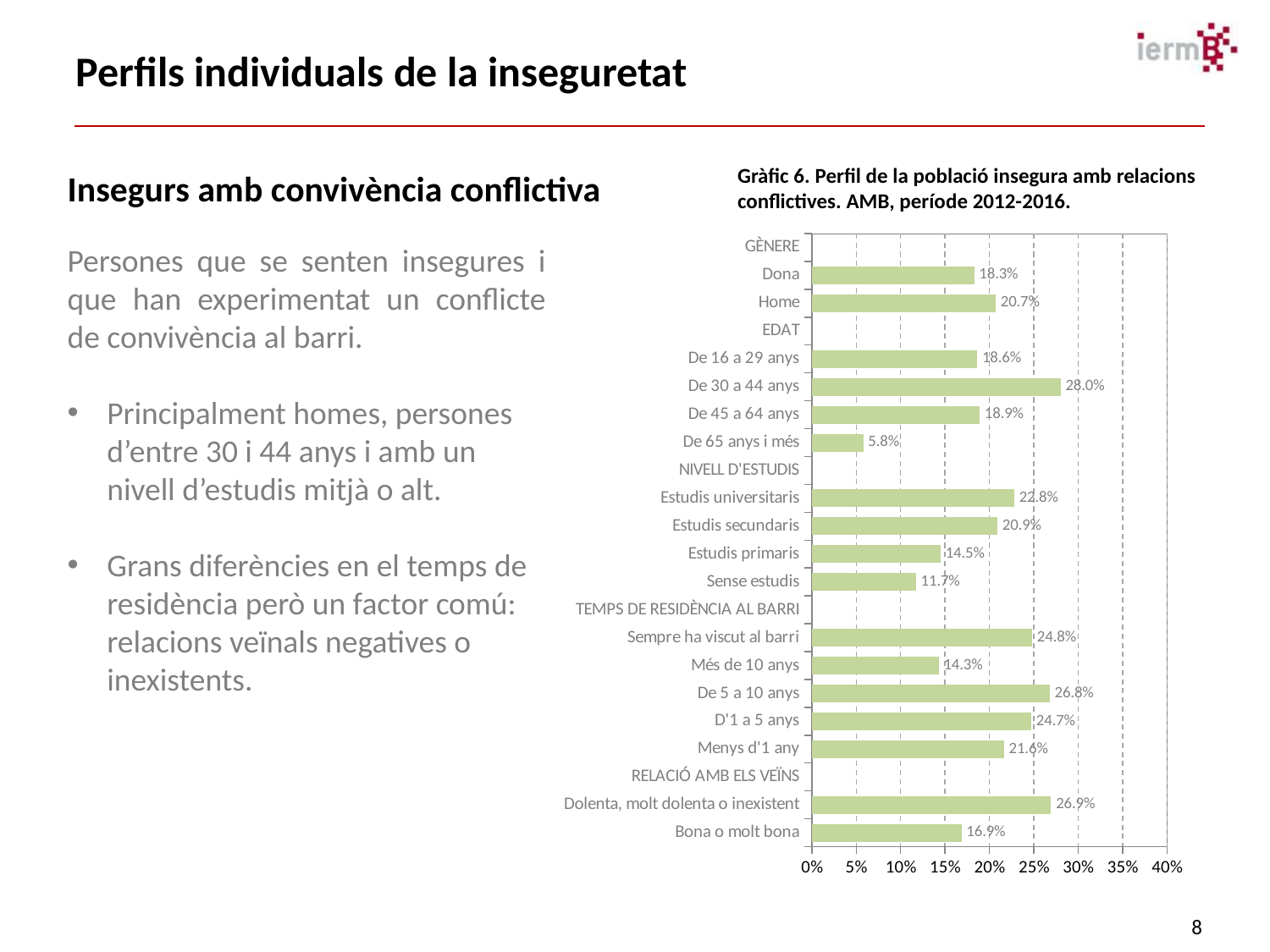
What is the value for "Sense estudis"? 11.7% What is the value for "De 30 a 44 anys"? 28.0% What is the value for "Dona"? 18.3% Which is larger, the value for "Estudis universitaris" or for "Estudis primaris"? Estudis universitaris What is the value for "Dolenta, molt dolenta o inexistent"? 26.9% What kind of chart is shown on the slide? bar chart What is the title of the chart? Gràfic 6. Perfil de la població insegura amb relacions conflictives. AMB, període 2012-2016. Which category has the highest value in the chart? De 30 a 44 anys What is the difference between the values for "Dolenta, molt dolenta o inexistent" and "Bona o molt bona"? 10.0% Is the value for "Més de 10 anys" greater or less than 20%? less Which category has the lowest value in the chart? De 65 anys i més What is the difference between the values for "Home" and "Dona"? 2.4%